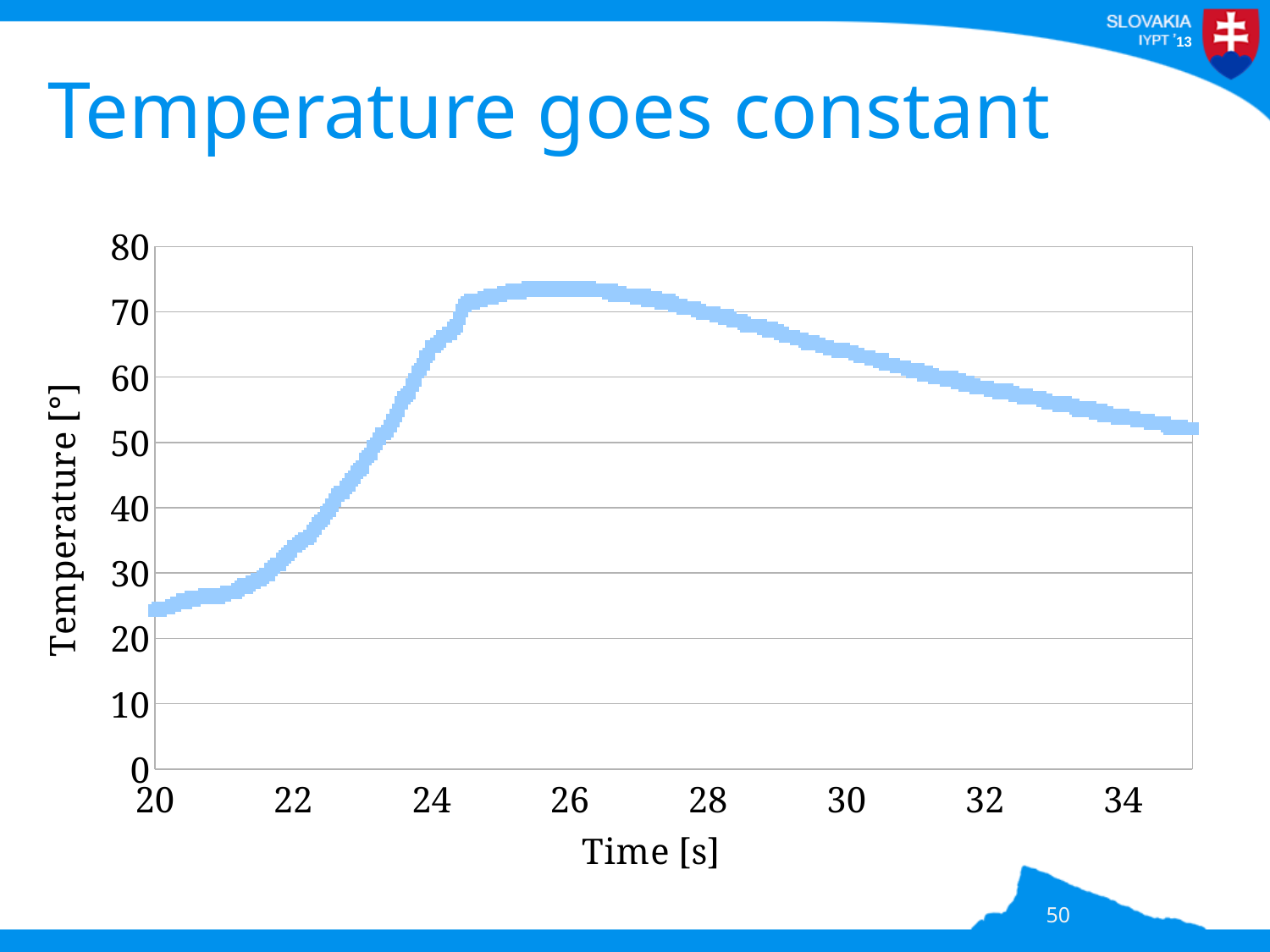
Does the temperature rise or fall between time 28 s and 34 s? fall What kind of chart is shown on the slide? line chart What is the label of the x axis? Time [s] Is the temperature at time 22 s greater or less than 40? less Does the temperature rise or fall between time 20 s and 26 s? rise Is the temperature at time 34 s greater or less than 50? greater Is the temperature at time 26 s greater or less than 70? greater Which is larger, the temperature at time 26 s or at time 34 s? time 26 s What is the label of the y axis? Temperature [°]